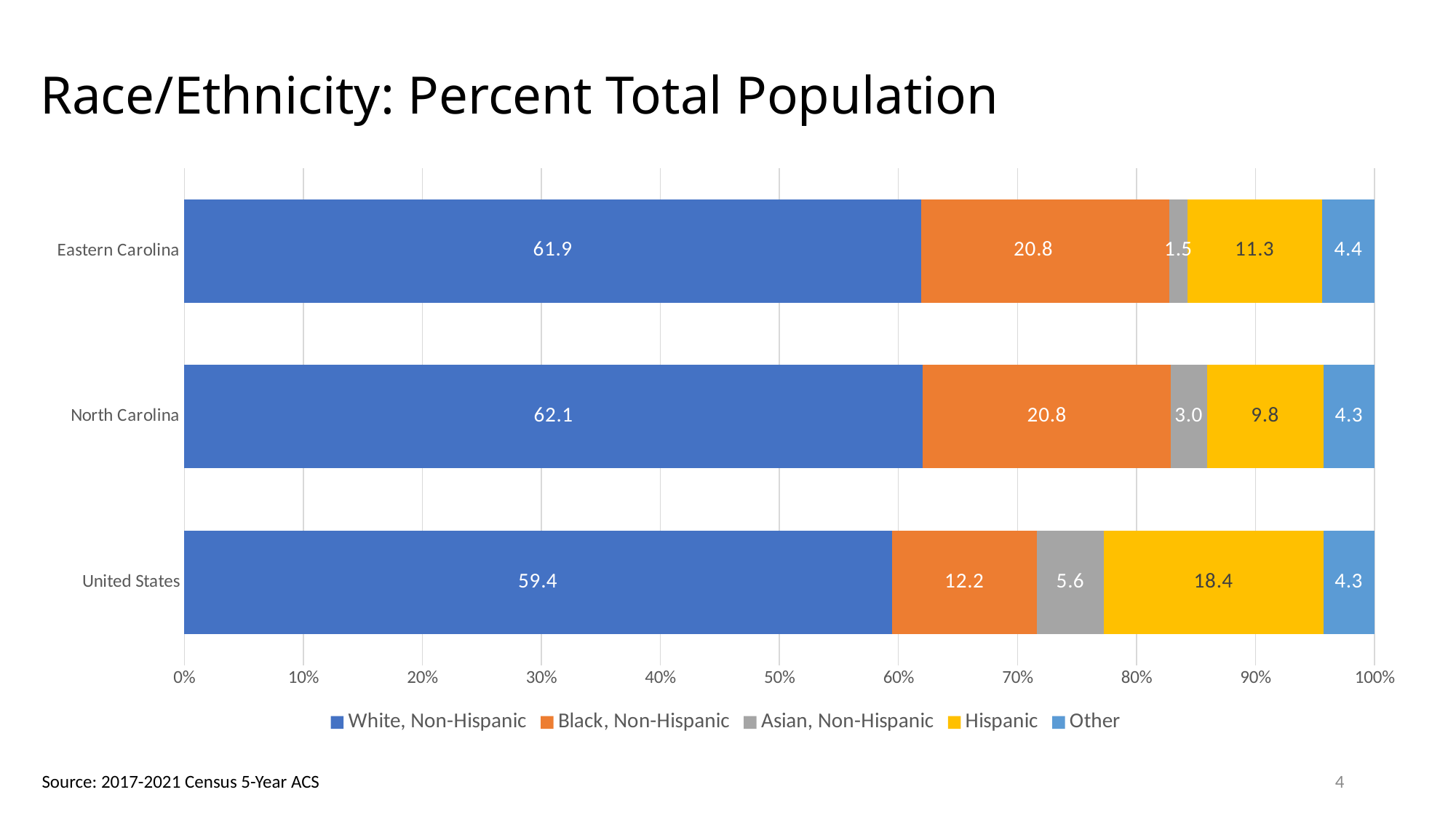
What is the difference between the Hispanic percentage for the United States and for North Carolina? 8.6 Which has a larger Hispanic percentage, Eastern Carolina or North Carolina? Eastern Carolina Which region has the lowest Asian, Non-Hispanic percentage? Eastern Carolina What is the difference between the Black, Non-Hispanic percentage for Eastern Carolina and for the United States? 8.6 What kind of chart is shown on the slide? Stacked bar chart What is the White, Non-Hispanic percentage for Eastern Carolina? 61.9 How many regions are shown on the chart? 3 What is the Other percentage for Eastern Carolina? 4.4 How many series does the legend list? 5 What is the Asian, Non-Hispanic percentage for North Carolina? 3.0 What is the Hispanic percentage for the United States? 18.4 Which region has the highest Hispanic percentage? United States